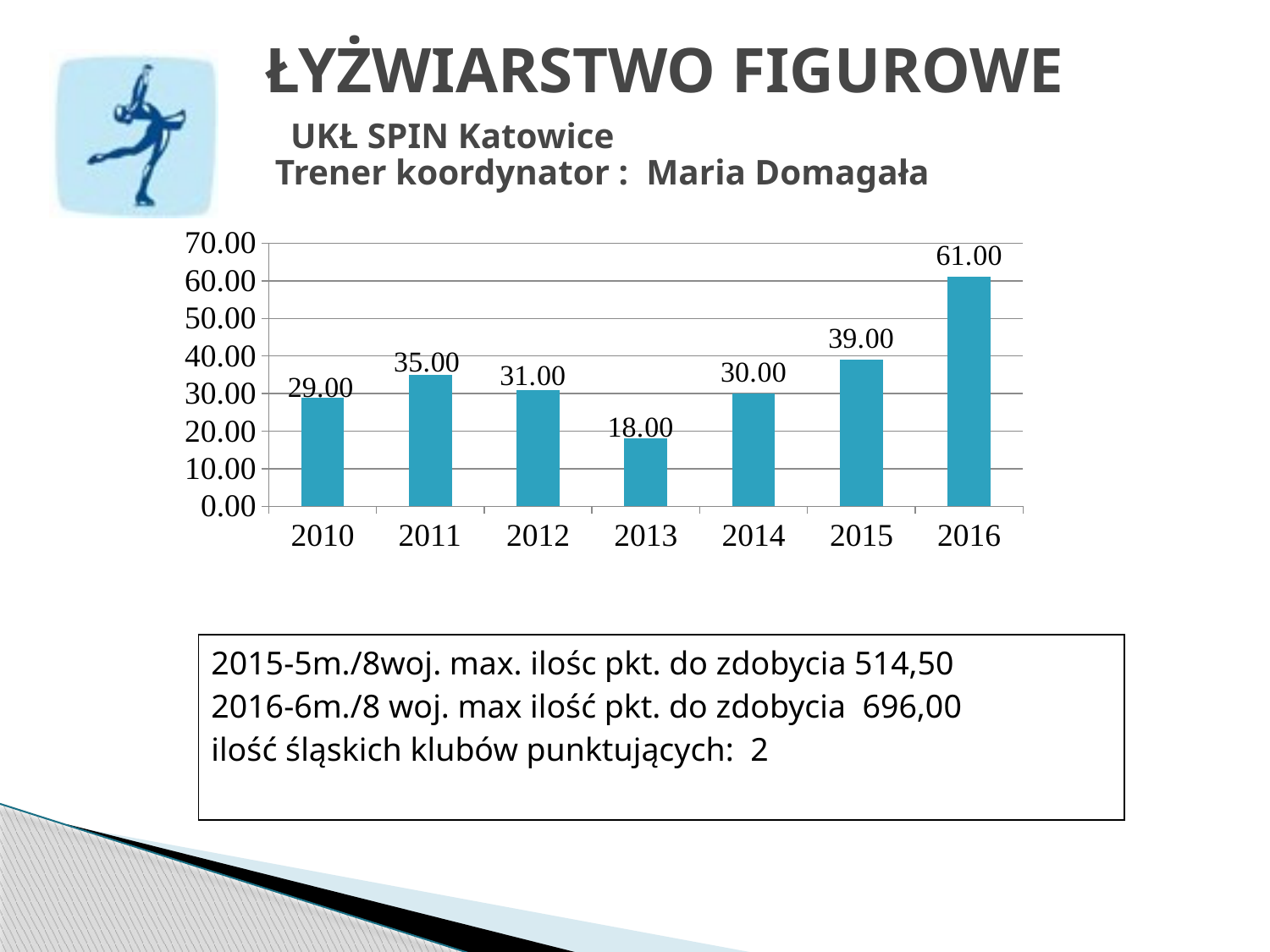
What is the difference between the values for 2016 and 2015? 22.00 Which is larger, the value for 2012 or the value for 2014? 2012 How many years are shown on the x axis? 7 Which year has the lowest value? 2013 What is the difference between the values for 2011 and 2010? 6.00 What is the value for 2016? 61.00 What is the value for 2013? 18.00 Do the values rise or fall from 2013 to 2016? rise Is the value for 2015 greater or less than 30.00? greater What kind of chart is shown on the slide? bar chart Which year has the highest value? 2016 What is the value for 2011? 35.00